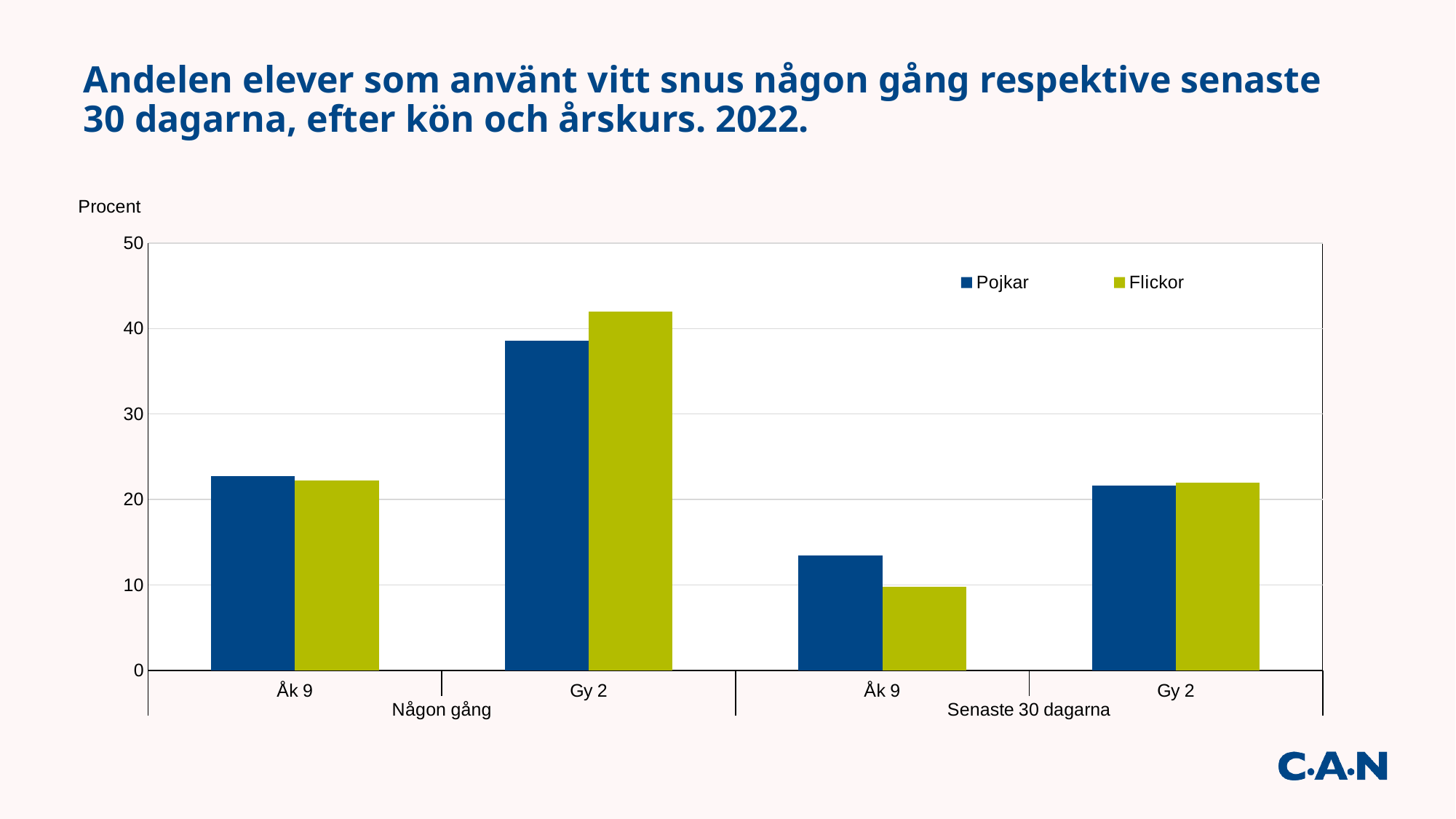
Is the value for Pojkar in Gy 2 under Någon gång greater or less than 30? greater For Åk 9 under Senaste 30 dagarna, which is larger, Pojkar or Flickor? Pojkar Which bar is the highest in the chart? Flickor, Gy 2, Någon gång How many series does the legend list? 2 Is the value for Pojkar in Åk 9 under Senaste 30 dagarna greater or less than 20? less What is the label on the vertical axis? Procent Which bar is the lowest in the chart? Flickor, Åk 9, Senaste 30 dagarna Which series are listed in the legend? Pojkar and Flickor What kind of chart is shown on the slide? bar chart For Gy 2 under Någon gång, which is larger, Pojkar or Flickor? Flickor How many category groups (pairs of bars) are plotted along the x axis? 4 Is the value for Flickor in Gy 2 under Någon gång greater or less than 40? greater